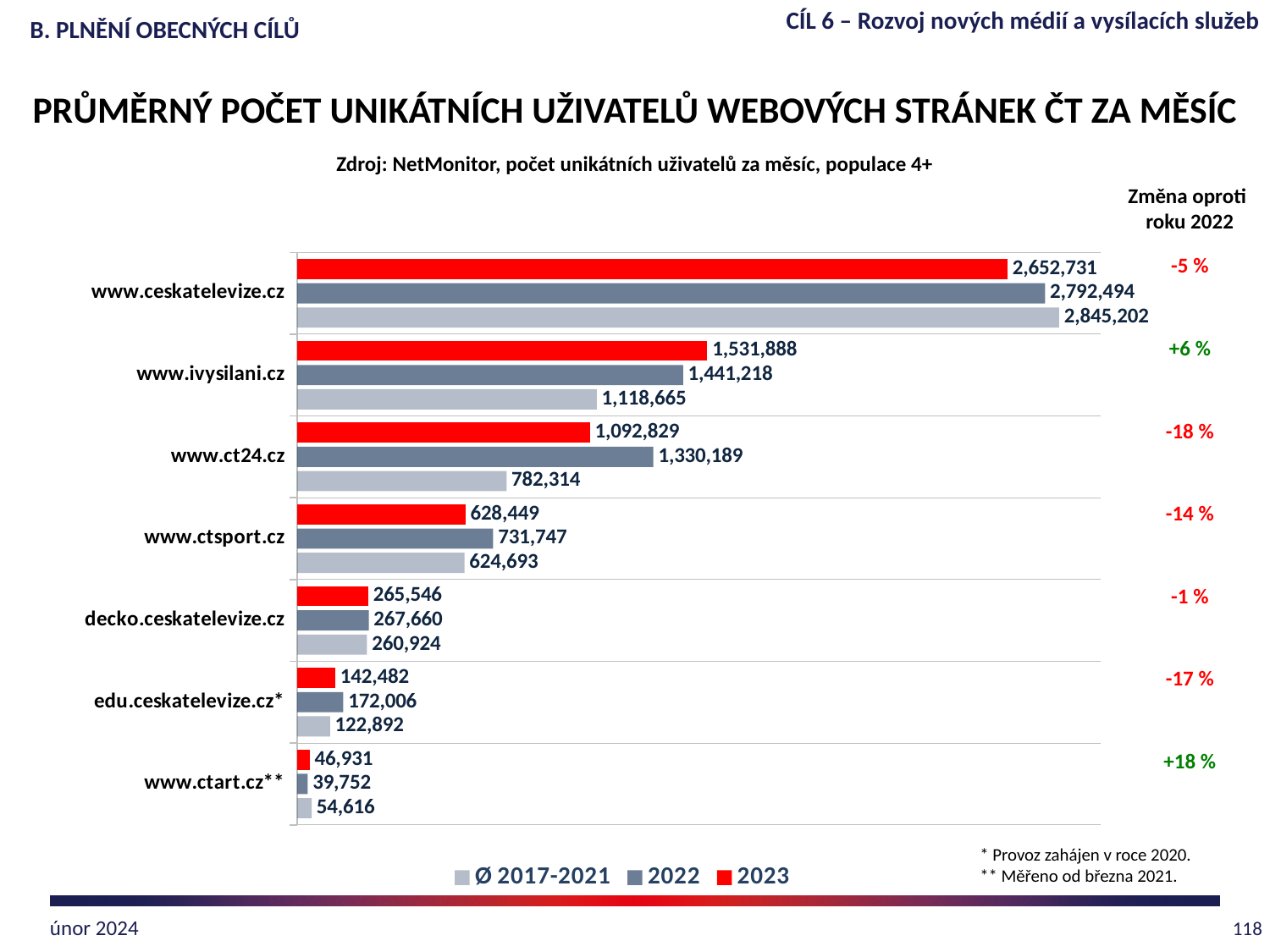
Which has the larger 2023 value, www.ct24.cz or www.ctsport.cz? www.ct24.cz How many websites are shown in the chart? 7 What change compared to 2022 is shown for www.ctart.cz**? +18 % What is the 2022 value for www.ct24.cz? 1,330,189 What is the 2023 value for www.ivysilani.cz? 1,531,888 What is the difference between the 2022 and 2023 values for www.ceskatelevize.cz? 139,763 Which website has the lowest 2023 value? www.ctart.cz** What kind of chart is shown on the slide? bar chart How many series does the legend list? 3 What is the Ø 2017-2021 value for decko.ceskatelevize.cz? 260,924 Which website has the highest 2023 value? www.ceskatelevize.cz What is the difference between the 2023 and 2022 values for www.ivysilani.cz? 90,670